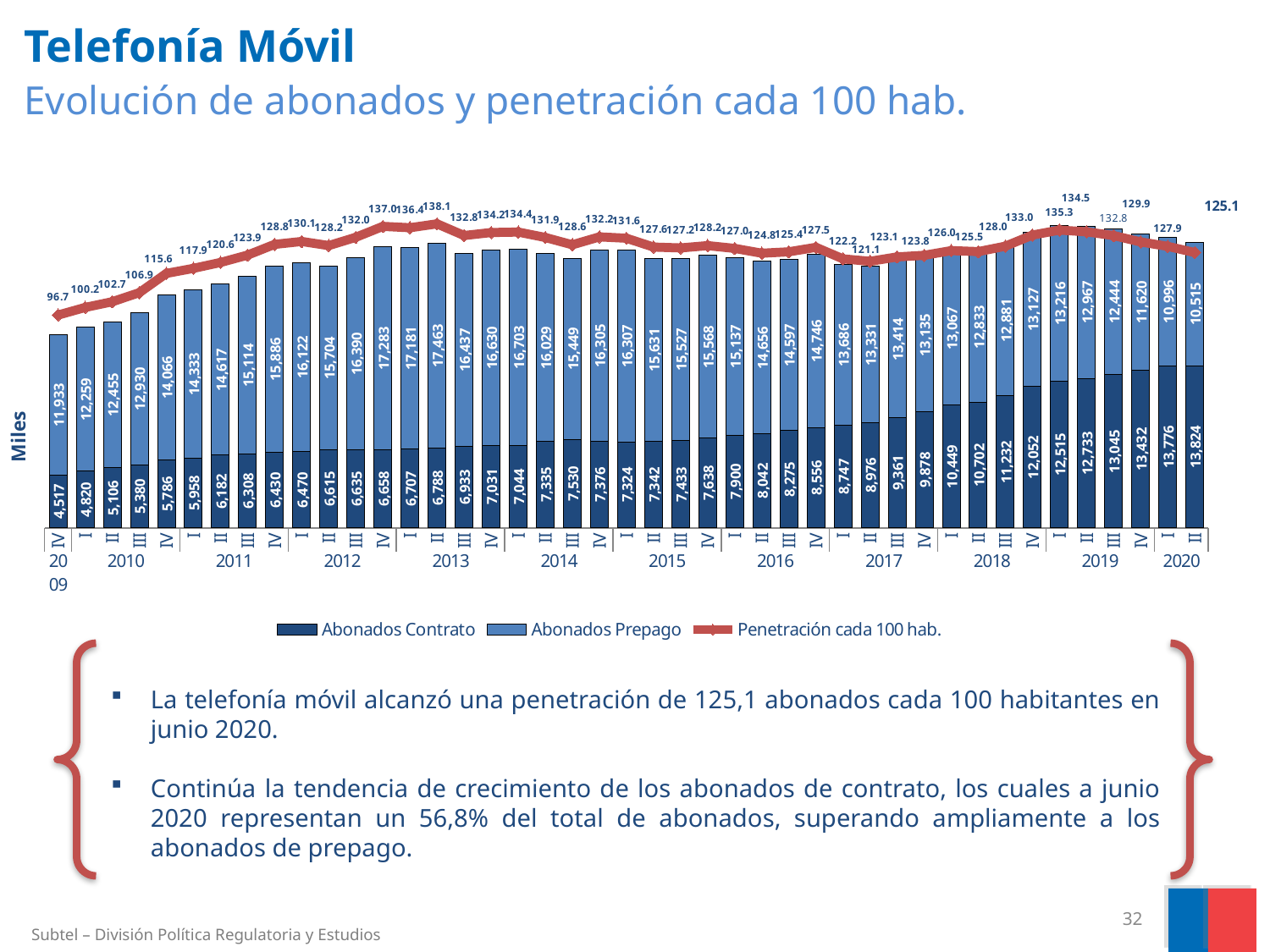
By how much does Abonados Contrato exceed Abonados Prepago in II 2020? 3,309 What is the value of Abonados Prepago for IV 2009? 11,933 What is the total of Abonados Contrato and Abonados Prepago for II 2020? 24,339 Which is larger: Abonados Prepago in II 2013 or Abonados Prepago in I 2012? II 2013 In which quarter does Penetración cada 100 hab. reach its highest value? II 2013 How many series does the legend list? 3 What kind of chart is shown on the slide? Stacked bar chart with a line In which quarter is Penetración cada 100 hab. lowest? IV 2009 Does Abonados Contrato rise or fall from IV 2009 to II 2020? Rises What is the Penetración cada 100 hab. value for II 2013? 138.1 In which quarter is Abonados Prepago highest? II 2013 What is the value of Abonados Contrato for II 2020? 13,824